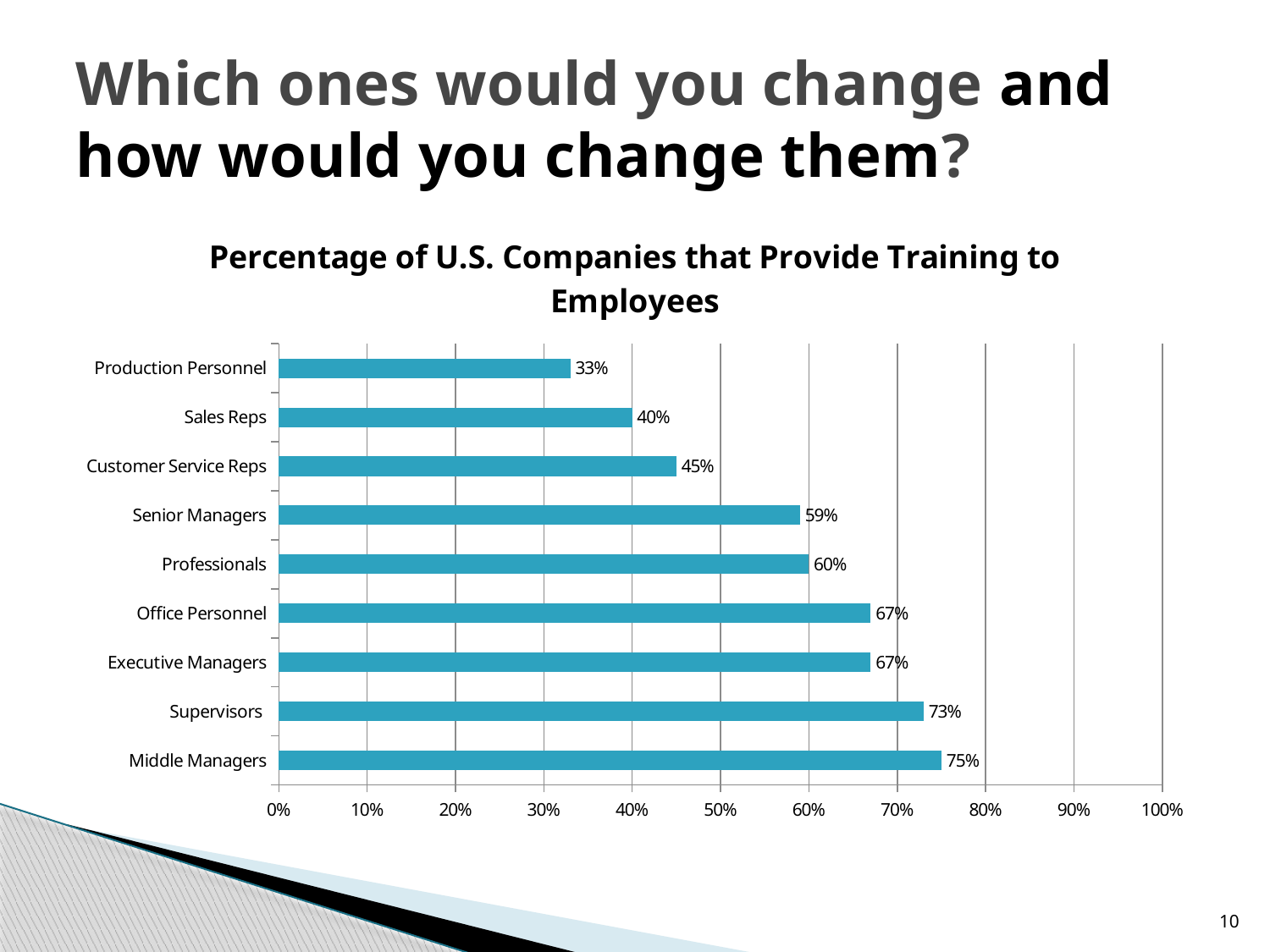
What is the difference between the percentages for Middle Managers and Production Personnel? 42% Which category has the lowest percentage? Production Personnel What is the title of the chart? Percentage of U.S. Companies that Provide Training to Employees What percentage of U.S. companies provide training to Sales Reps? 40% What percentage is shown for Supervisors? 73% How many categories are shown in the chart? 9 What is the difference between the values for Customer Service Reps and Sales Reps? 5% What is the value shown for Senior Managers? 59% Which category has the highest percentage? Middle Managers Which is larger, the value for Professionals or the value for Customer Service Reps? Professionals Is the value for Office Personnel greater or less than 50%? greater What kind of chart is shown on the slide? Bar chart